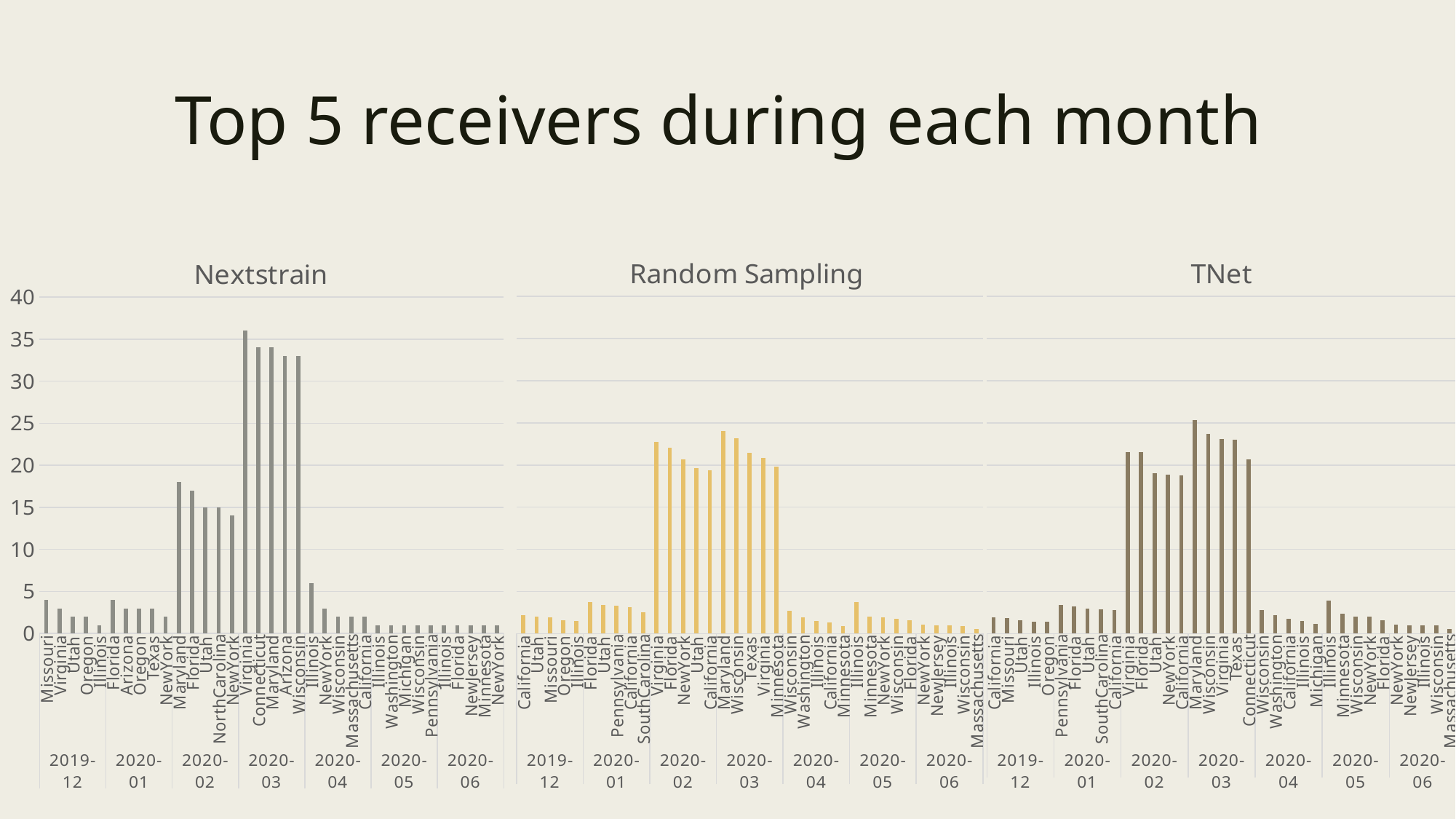
How many separate charts are shown on the slide? 3 In the TNet chart, is the value for Illinois in 2020-05 greater or less than 5? less In the Nextstrain chart, which state has the tallest bar? Virginia Which of the three charts contains the tallest bar overall? Nextstrain In the Nextstrain chart, is the value for Virginia in 2020-03 greater or less than 30? greater In the Nextstrain chart, do the bar heights generally rise or fall from 2020-03 through 2020-06? fall How many month groups are shown along the x axis of the TNet chart? 7 In the Random Sampling chart, is the value for Virginia in 2020-02 greater or less than 20? greater In the Nextstrain chart, which is larger: the value for Maryland in 2020-02 or the value for Illinois in 2020-04? Maryland in 2020-02 What is the title of the slide? Top 5 receivers during each month What kind of chart is used for the Nextstrain panel? bar chart In the TNet chart, which state has the tallest bar? Maryland